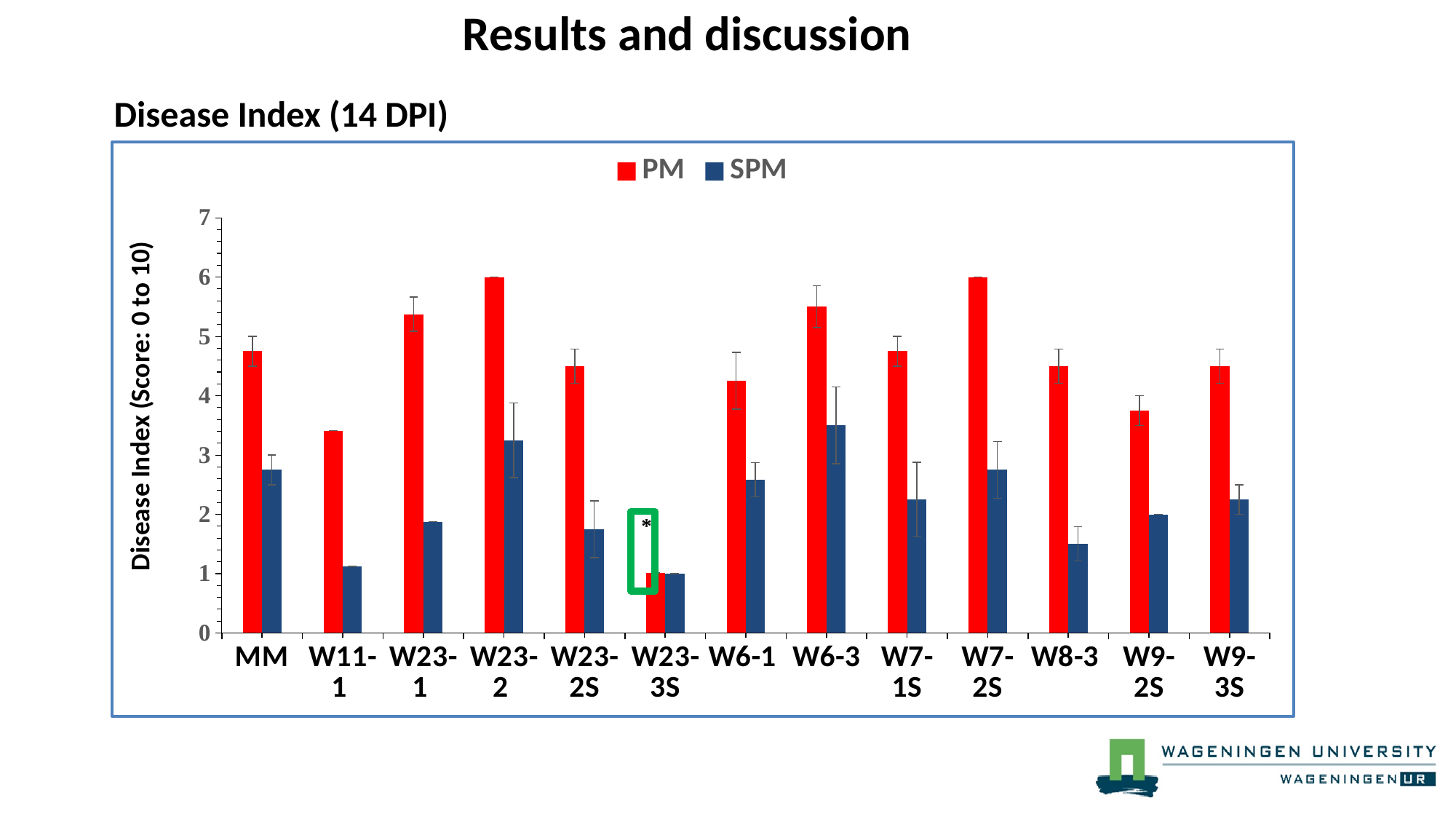
Is the SPM value for W6-3 greater or less than 3? greater For W11-1, which series has the larger value, PM or SPM? PM What is the title of the y axis? Disease Index (Score: 0 to 10) Is the PM value for MM greater or less than 4? greater What are the two series named in the legend? PM and SPM Is the SPM value for W8-3 greater or less than 2? less Which category has the lowest PM value? W23-3S What kind of chart is shown on the slide? bar chart How many series does the legend list? 2 How many categories are shown on the x axis? 13